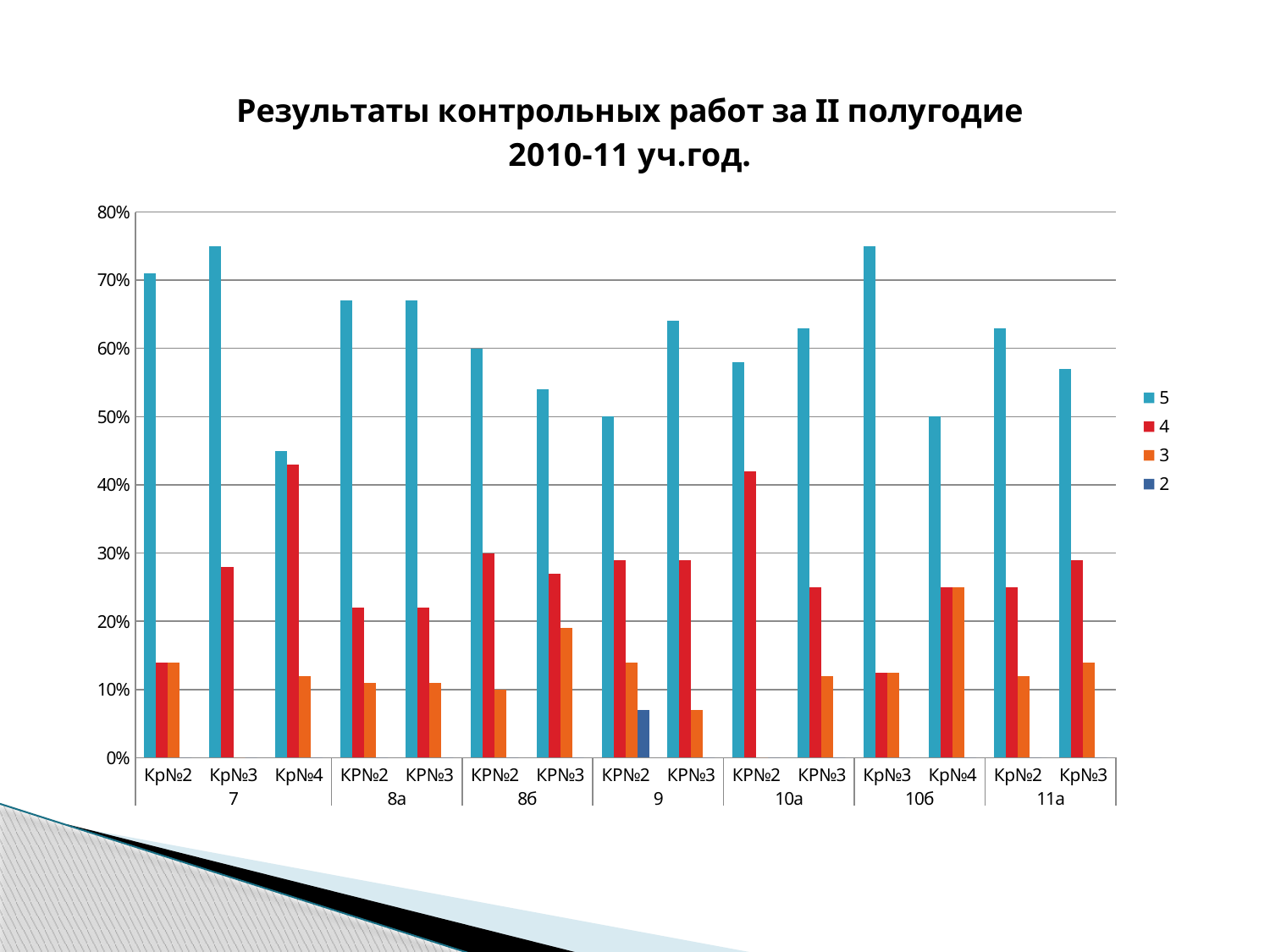
Is the value of series 2 for КР№2 in class 9 greater or less than 10%? less What is the value of series 4 for КР№2 in class 8б? 30% For КР№2 in class 10а, which is larger: the value of series 5 or series 4? series 5 What is the value of series 5 for КР№2 in class 8б? 60% What is the title of the chart? Результаты контрольных работ за II полугодие 2010-11 уч.год. How many series does the legend list? 4 How many category groups (контрольные работы) are plotted along the x axis? 15 What is the value of series 5 for КР№2 in class 9? 50% What are the legend entries of the chart? 5, 4, 3, 2 What kind of chart is shown on the slide? bar chart Is the value of series 5 for КР№4 in class 7 greater or less than 50%? less Is the value of series 5 for КР№3 in class 7 greater or less than 70%? greater